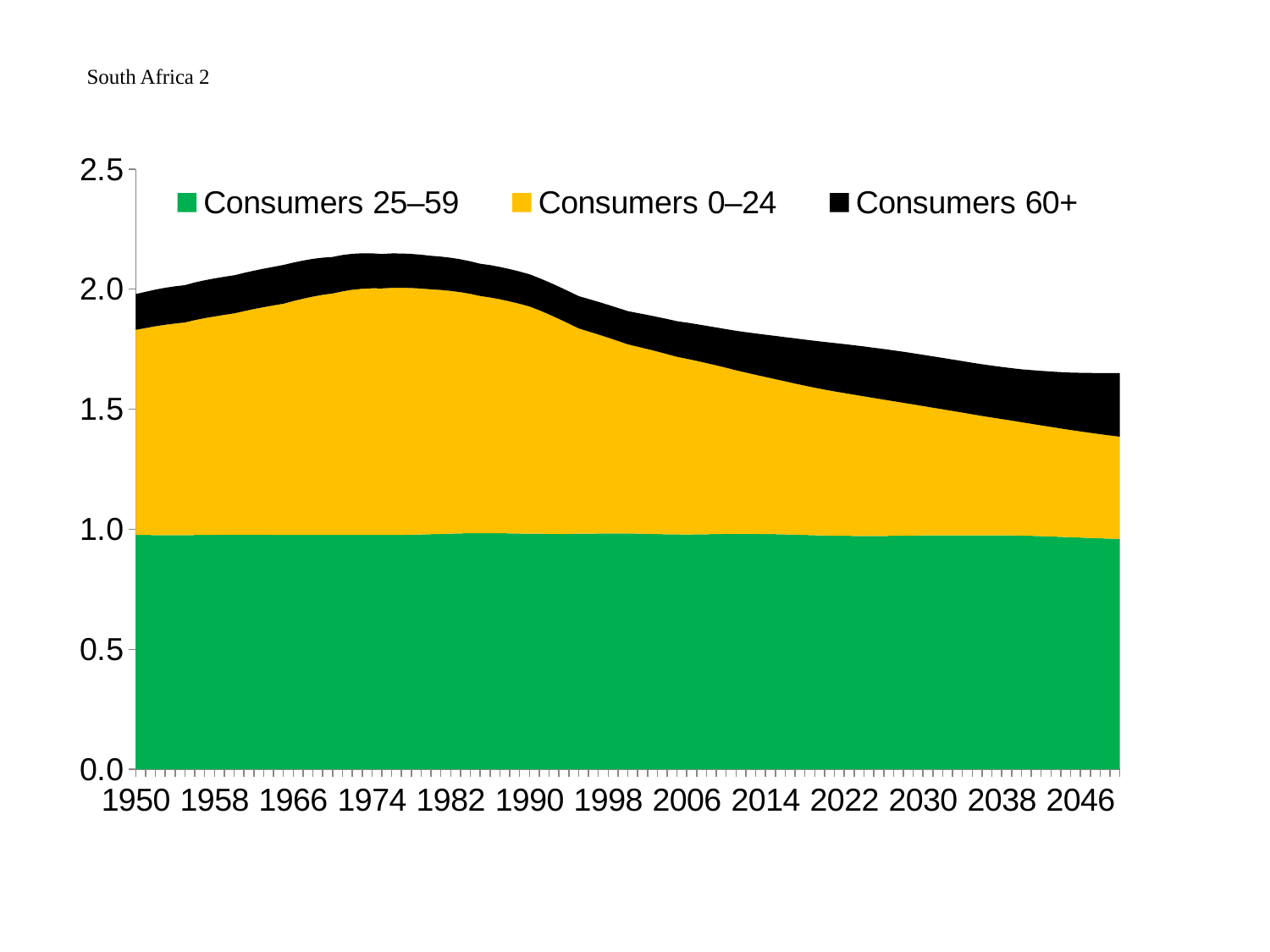
Is the Consumers 60+ band larger in 1950 or in 2046? 2046 How many series does the legend list? 3 Which series is shown in black? Consumers 60+ What kind of chart is shown on the slide? Stacked area chart What is the title of the slide? South Africa 2 Is the cumulative top of the Consumers 0–24 band in 2046 greater or less than 1.5? less Which series has the smallest value in 1950? Consumers 60+ Is the total stacked value in 1974 greater or less than 2.0? greater Is the total stacked value in 2046 greater or less than 2.0? less Which series has the largest value in 2046? Consumers 25–59 Does the total stacked value rise or fall between 1990 and 2046? fall